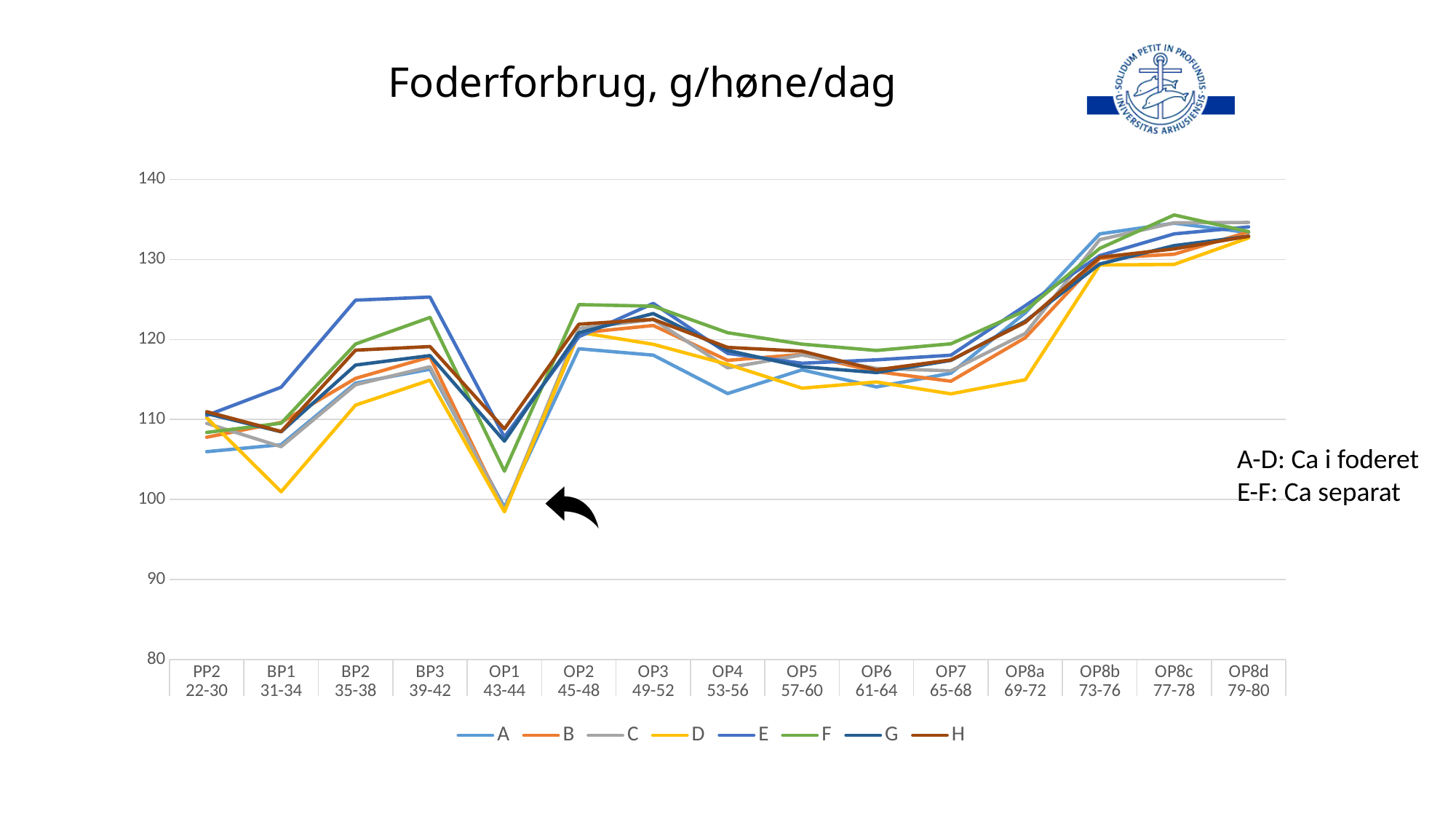
Is the value for series A at OP4 53-56 greater or less than 120? less Which series has the highest value at BP2 35-38? E What kind of chart is shown on the slide? line chart Is the value for series E at BP2 35-38 greater or less than 120? greater From OP8a 69-72 to OP8d 79-80, do the values of the series rise or fall? rise How many categories are shown on the x axis? 15 What is the title of the chart? Foderforbrug, g/høne/dag According to the note on the slide, which series received Ca separately (Ca separat)? E-F Which series has the lowest value at BP1 31-34? D Is the value for series F at OP8c 77-78 greater or less than 130? greater How many series does the legend list? 8